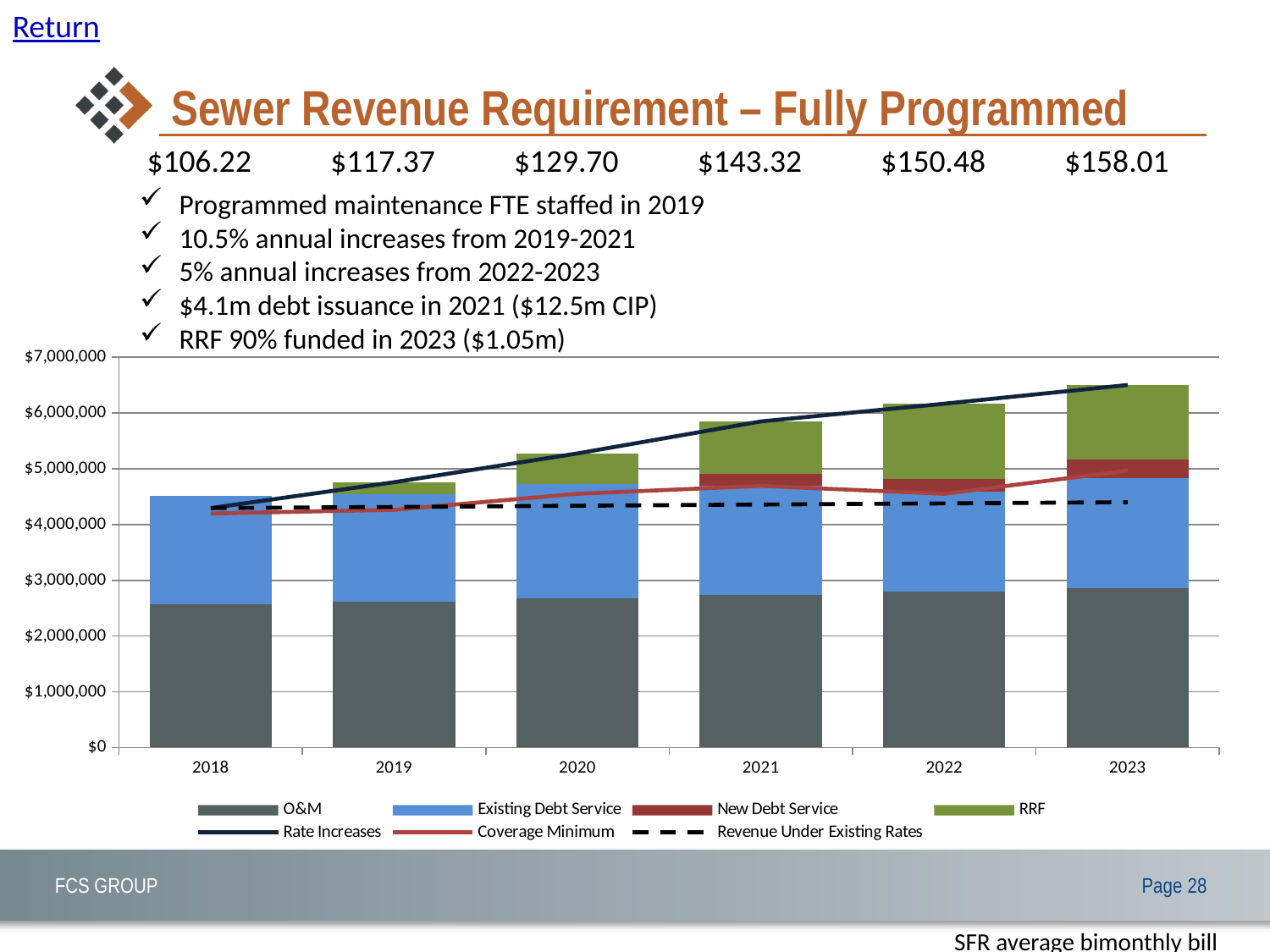
Which year has the tallest stacked bar? 2023 Is the total stacked bar for 2018 greater or less than $4,000,000? greater What is the title of the chart slide? Sewer Revenue Requirement – Fully Programmed How many years are shown on the x axis of the chart? 6 How many series does the chart legend list? 7 Which year has the shortest stacked bar? 2018 Is the total stacked bar for 2023 greater or less than $6,000,000? greater Is the O&M value for 2018 greater or less than $3,000,000? less What kind of chart is shown on the slide? Stacked bar chart with lines Which legend entry is shown in green? RRF Does the Rate Increases line rise or fall from 2018 to 2023? Rise Which is larger, the total stacked bar for 2021 or for 2019? 2021